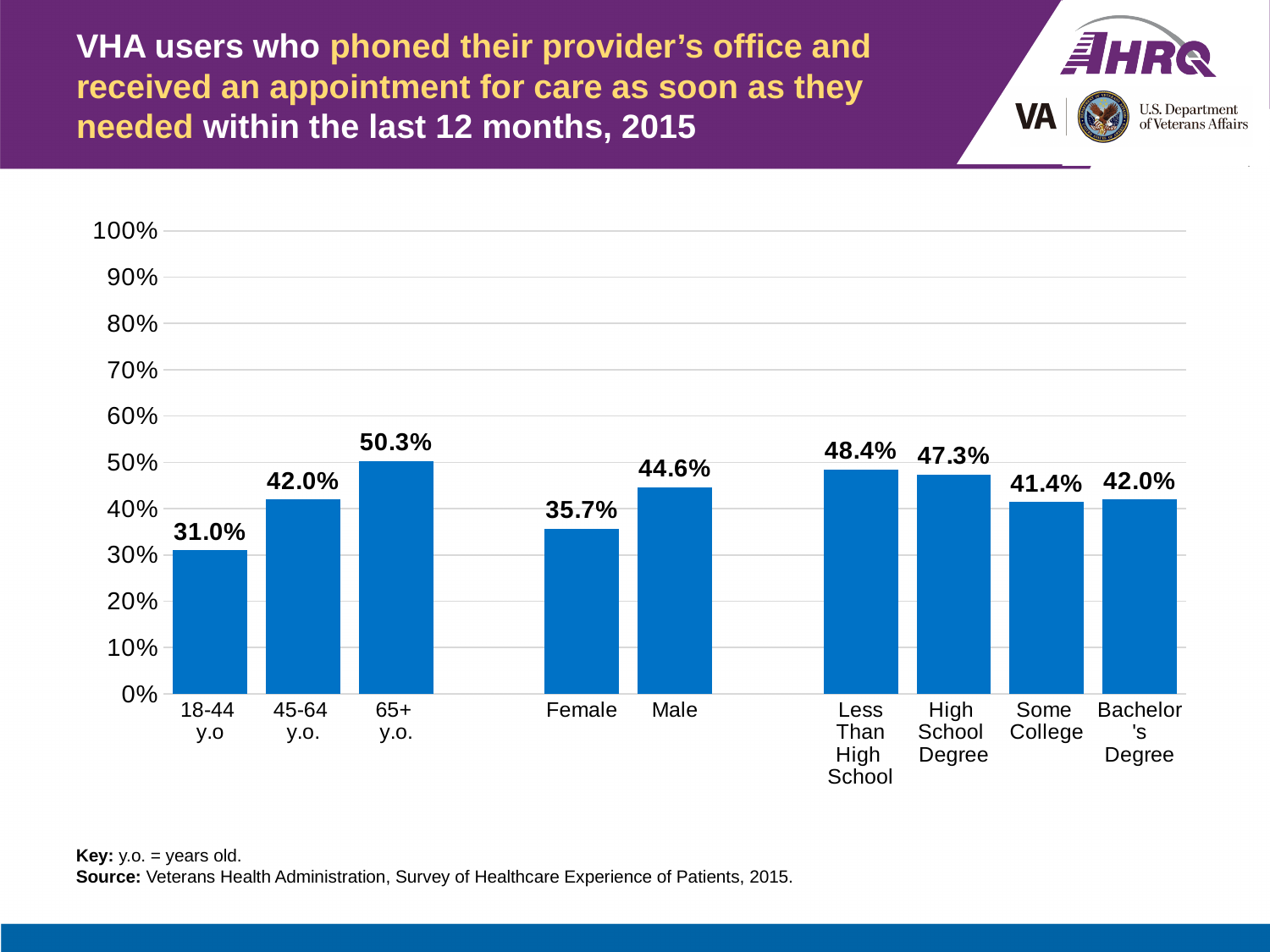
Which category has the lowest value on the chart? 18-44 y.o What kind of chart is shown on the slide? bar chart Do the values rise or fall across the age groups from 18-44 y.o to 65+ y.o.? rise Is the value for 45-64 y.o. greater or less than 50%? less How many bars are plotted on the chart? 9 What is the difference between the values for Male and Female? 8.9% Which is larger, the value for High School Degree or the value for Some College? High School Degree What is the value for Less Than High School? 48.4% What is the value for the 65+ y.o. group? 50.3% What is the difference between the values for 65+ y.o. and 18-44 y.o? 19.3% What is the value for Female? 35.7% Which category has the highest value on the chart? 65+ y.o.